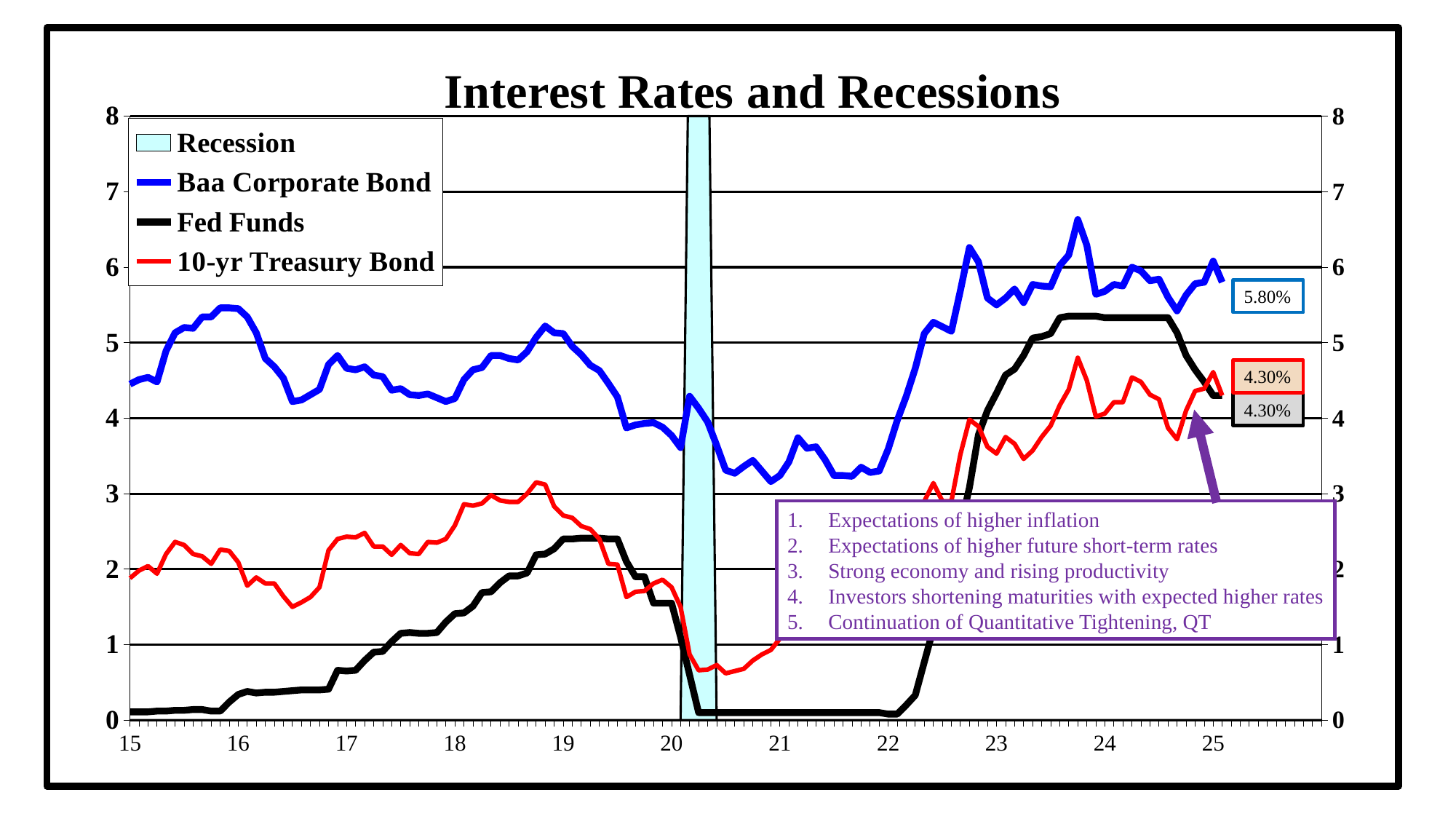
What is the title of the chart? Interest Rates and Recessions What is the latest labelled value for the Fed Funds series? 4.30% What is the difference between the latest labelled Baa Corporate Bond value and the latest labelled Fed Funds value? 1.50% Does the Fed Funds rate rise or fall between 2022 and 2023? rise How many entries does the chart's legend list? 4 What is the latest labelled value for the Baa Corporate Bond series? 5.80% What kind of chart is shown on the slide? line chart Is the peak of the Baa Corporate Bond series in 2023 greater or less than 6? greater Is the Fed Funds rate during 2021 greater or less than 1? less At the end of the chart, which is larger: the Baa Corporate Bond rate or the Fed Funds rate? Baa Corporate Bond What is the latest labelled value for the 10-yr Treasury Bond series? 4.30% Which series reaches the highest value on the chart? Baa Corporate Bond